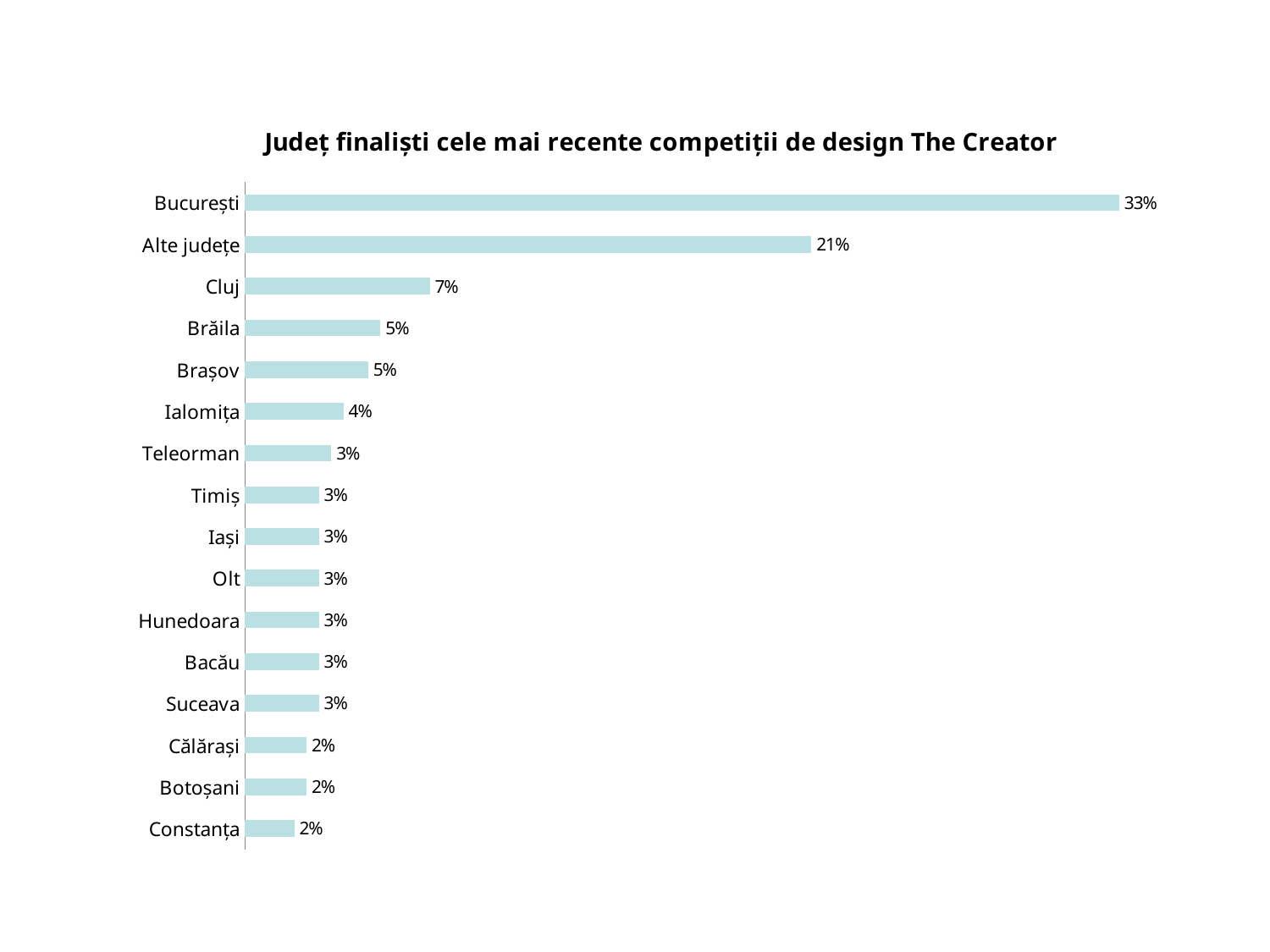
How many categories are shown in the chart? 16 What is the difference between the values for București and Alte județe? 12% What is the difference between the values for Cluj and Brăila? 2% What is the value for Alte județe? 21% What is the title of the chart? Județ finaliști cele mai recente competiții de design The Creator Which is larger, the value for Ialomița or the value for Teleorman? Ialomița What is the value for Ialomița? 4% What kind of chart is shown on the slide? Bar chart What is the value for Cluj? 7% Which category has the highest value? București What is the value for București? 33% Which is larger, the value for Cluj or the value for Brașov? Cluj